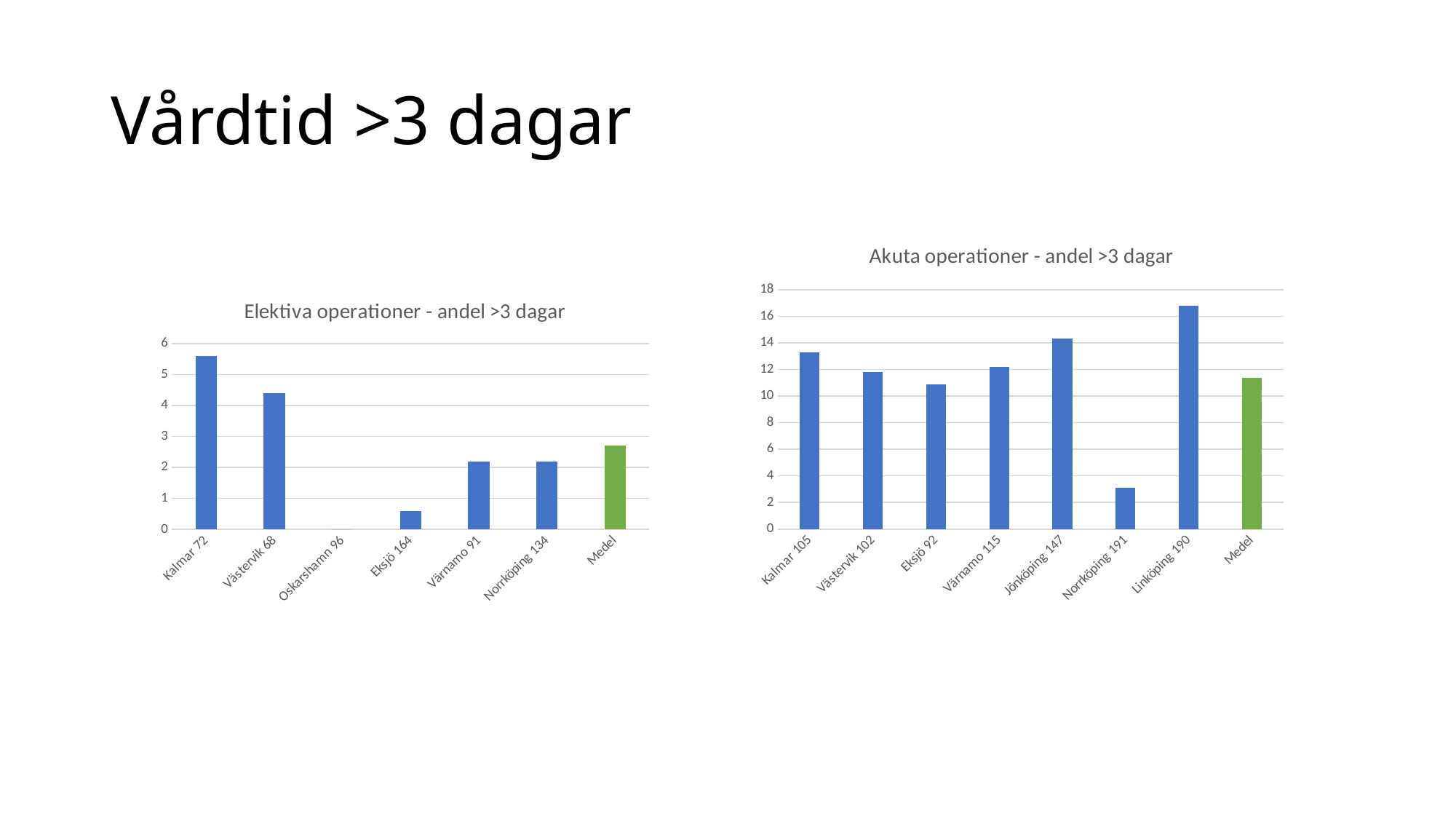
In the chart titled 'Akuta operationer - andel >3 dagar', is the value for Norrköping 191 greater or less than 4? less In the chart titled 'Elektiva operationer - andel >3 dagar', which category has the lowest value? Oskarshamn 96 What type of chart is the chart titled 'Akuta operationer - andel >3 dagar'? bar chart In the chart titled 'Akuta operationer - andel >3 dagar', which category has the lowest bar? Norrköping 191 In the chart titled 'Akuta operationer - andel >3 dagar', is the value for Medel greater or less than 10? greater How many categories are shown on the x axis of the chart titled 'Elektiva operationer - andel >3 dagar'? 7 In the chart titled 'Akuta operationer - andel >3 dagar', which category has the highest bar? Linköping 190 In the chart titled 'Elektiva operationer - andel >3 dagar', which is larger, the value for Kalmar 72 or Västervik 68? Kalmar 72 In the chart titled 'Akuta operationer - andel >3 dagar', which is larger, the value for Jönköping 147 or Värnamo 115? Jönköping 147 In the chart titled 'Elektiva operationer - andel >3 dagar', is the value for Kalmar 72 greater or less than 5? greater In the chart titled 'Elektiva operationer - andel >3 dagar', which category has the highest bar? Kalmar 72